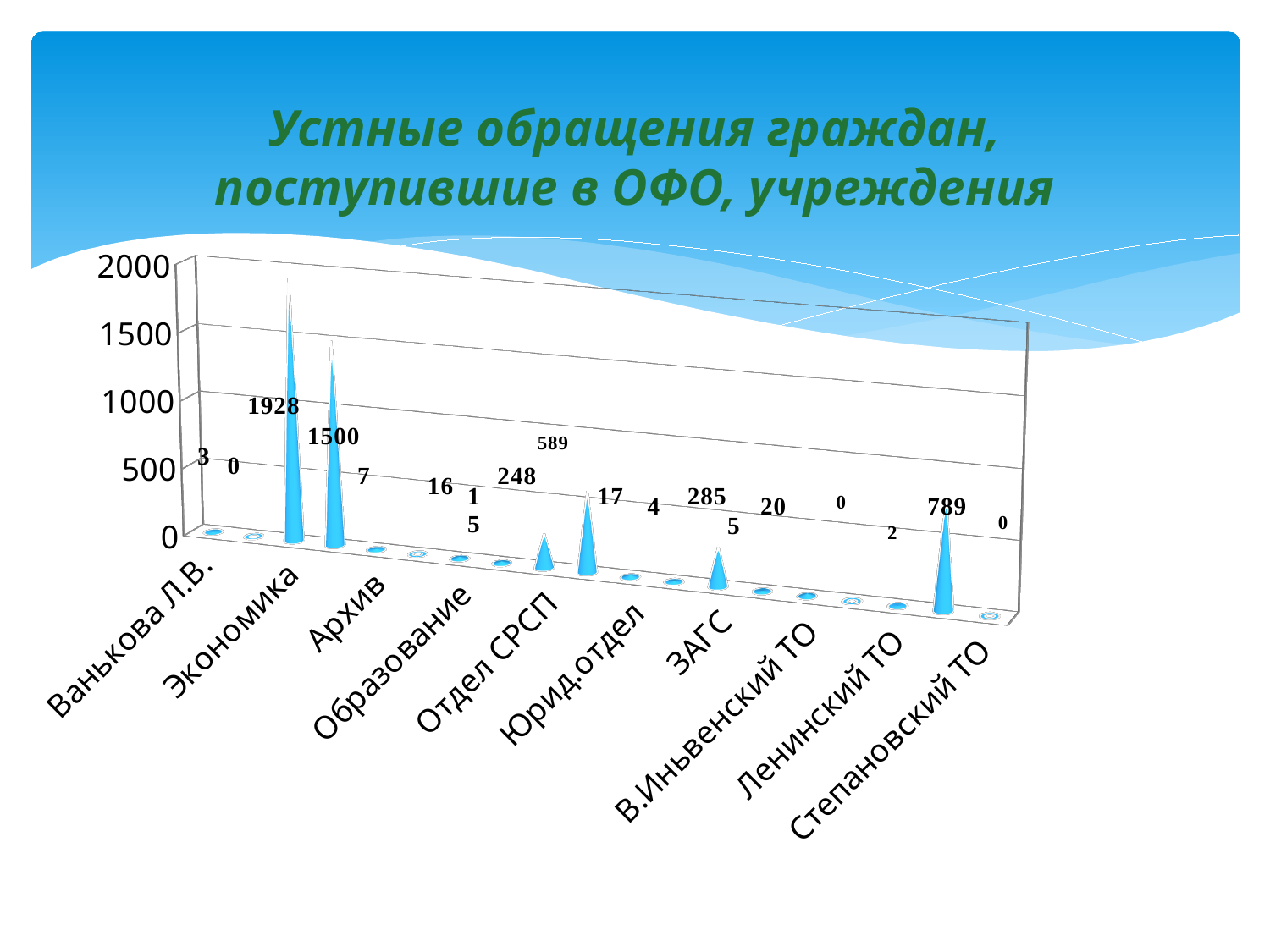
How many category labels are shown along the x axis? 10 Is the value for Экономика greater or less than 1500? greater What is the difference between the two largest values printed on the chart, 1928 and 1500? 428 Is the value for Экономика greater or less than 1000? greater What is the title of the slide containing the chart? Устные обращения граждан, поступившие в ОФО, учреждения What is the highest value printed on the chart? 1928 Which category has the tallest bar on the chart? Экономика What kind of chart is shown on the slide? bar chart What is the highest tick value on the vertical axis? 2000 What is the lowest value printed on the chart? 0